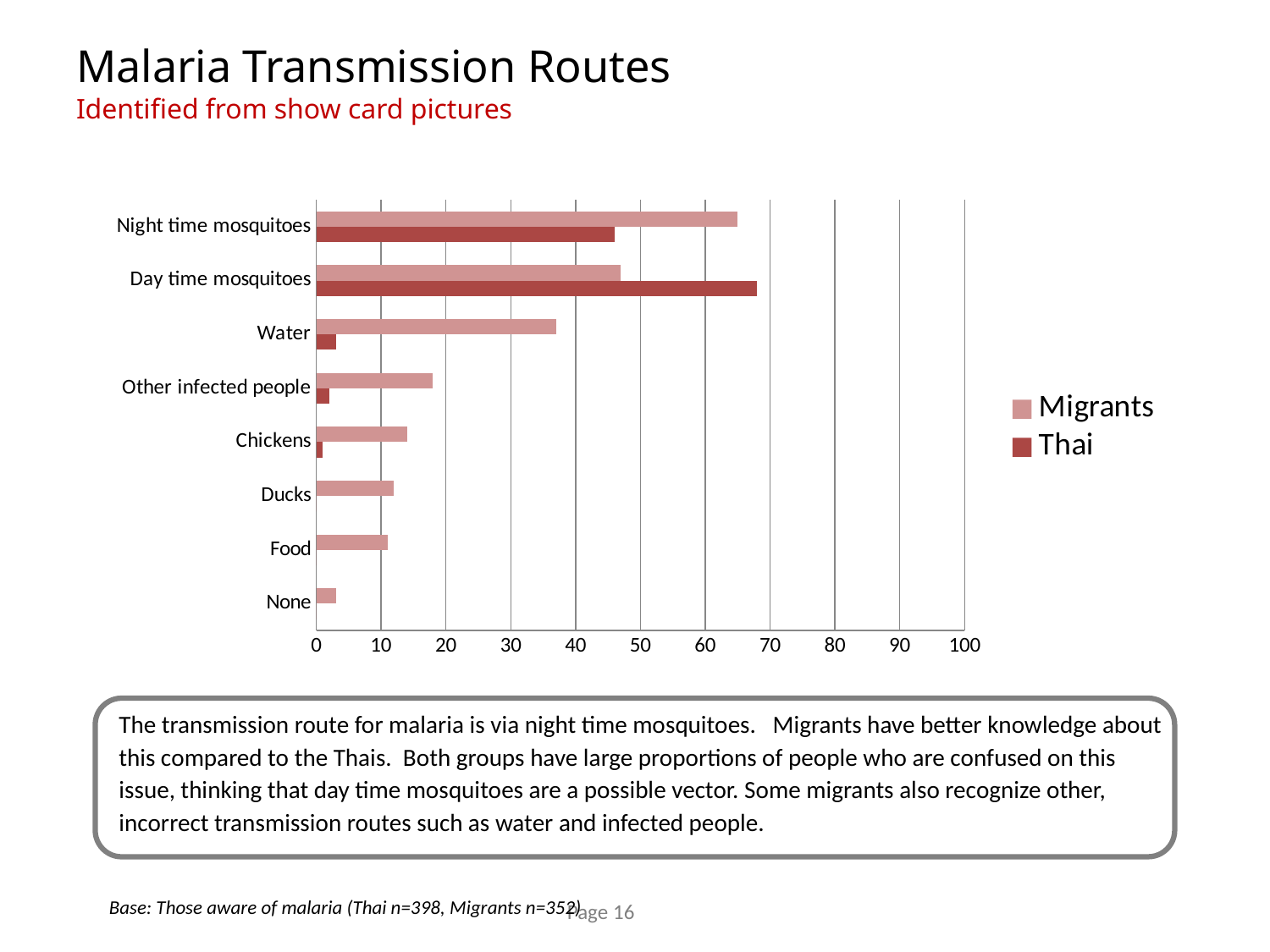
Is the Thai value for Day time mosquitoes greater or less than 60? greater For Night time mosquitoes, which group has the larger value, Migrants or Thai? Migrants What is the title of the chart on the slide? Malaria Transmission Routes Is the Migrants value for Water greater or less than 30? greater How many series does the legend list? 2 Which category has the highest value for Migrants? Night time mosquitoes What kind of chart is shown on the slide? bar chart How many transmission route categories are shown on the chart? 8 For Day time mosquitoes, which group has the larger value, Migrants or Thai? Thai Is the Migrants value for Night time mosquitoes greater or less than 60? greater Which category has the highest value for Thai? Day time mosquitoes Which category has the lowest value for Migrants? None